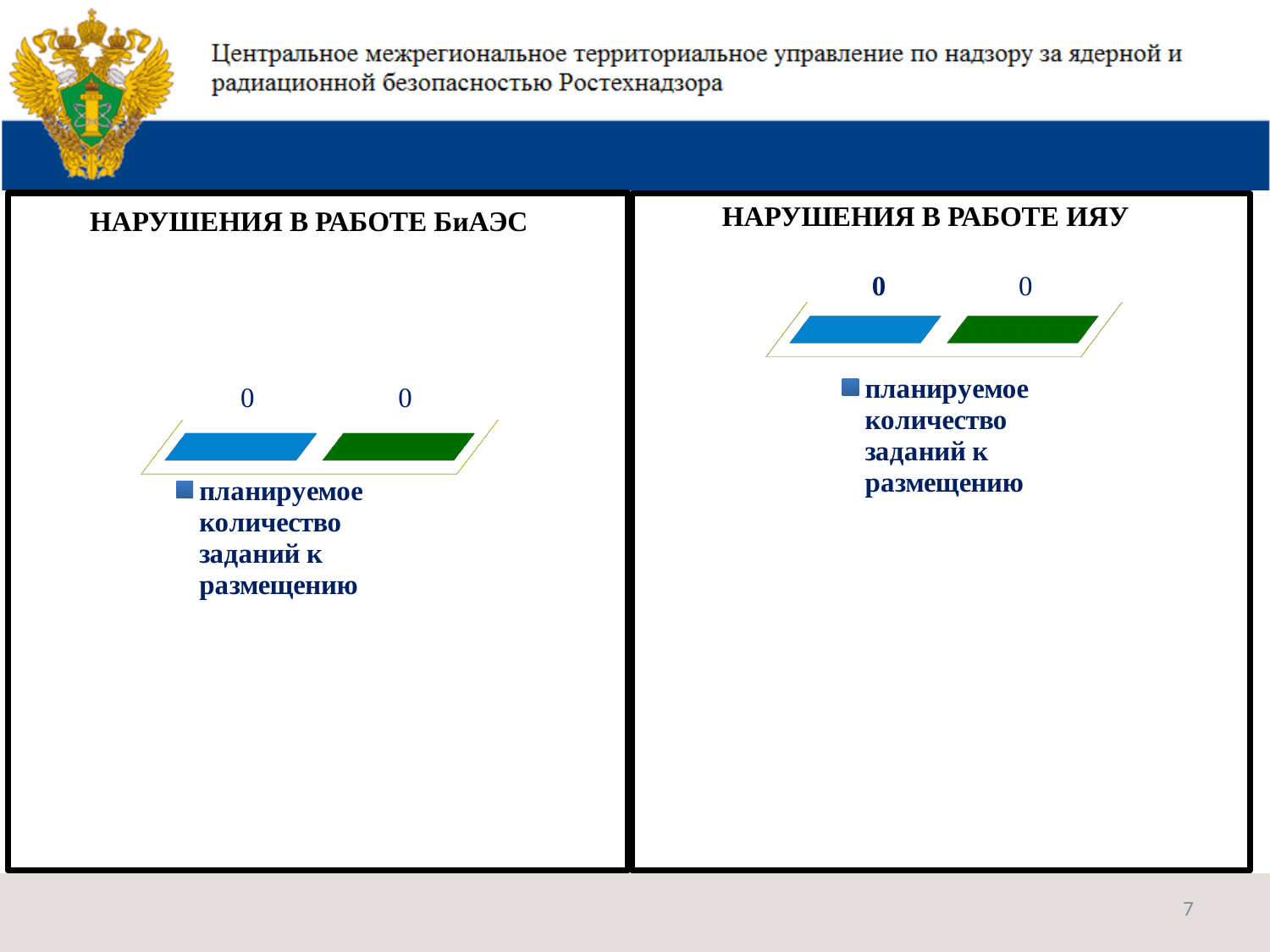
What kind of chart is the one titled 'НАРУШЕНИЯ В РАБОТЕ БиАЭС'? bar chart In the chart titled 'НАРУШЕНИЯ В РАБОТЕ ИЯУ', what is the difference between the value of the blue bar and the value of the green bar? 0 In the chart titled 'НАРУШЕНИЯ В РАБОТЕ ИЯУ', how many series does the legend list? 1 In the chart titled 'НАРУШЕНИЯ В РАБОТЕ БиАЭС', how many bars are plotted? 2 In the chart titled 'НАРУШЕНИЯ В РАБОТЕ ИЯУ', what value is printed above the blue bar? 0 In the chart titled 'НАРУШЕНИЯ В РАБОТЕ БиАЭС', what value is printed above the blue bar? 0 In the chart titled 'НАРУШЕНИЯ В РАБОТЕ ИЯУ', how many bars are plotted? 2 What is the legend entry shown in the chart titled 'НАРУШЕНИЯ В РАБОТЕ БиАЭС'? планируемое количество заданий к размещению What is the title of the chart on the right side of the slide? НАРУШЕНИЯ В РАБОТЕ ИЯУ In the chart titled 'НАРУШЕНИЯ В РАБОТЕ БиАЭС', what value is printed above the green bar? 0 In the chart titled 'НАРУШЕНИЯ В РАБОТЕ БиАЭС', how many series does the legend list? 1 In the chart titled 'НАРУШЕНИЯ В РАБОТЕ ИЯУ', what value is printed above the green bar? 0